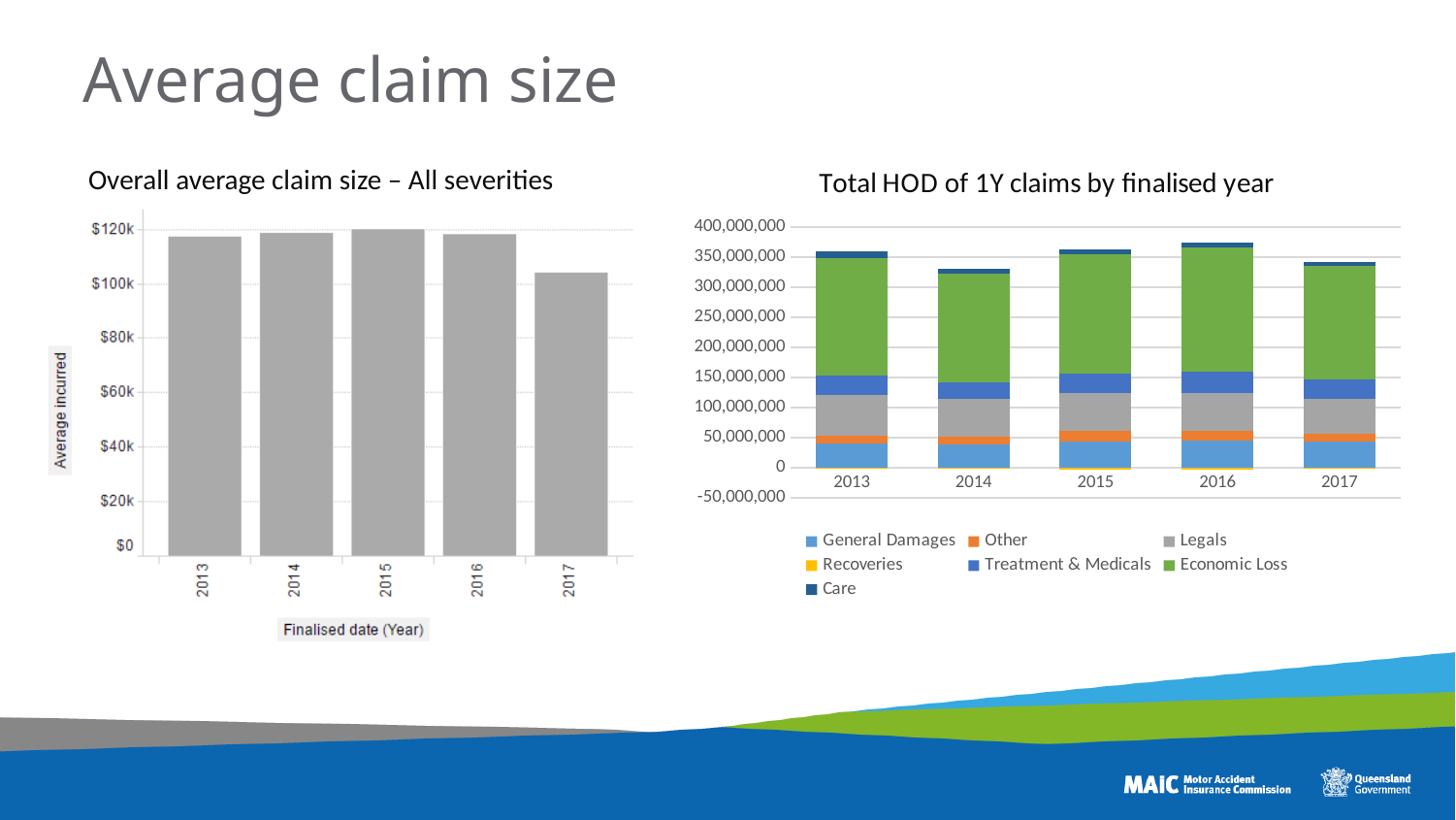
In the 'Total HOD of 1Y claims by finalised year' chart, is the total stacked bar for 2016 greater or less than 350,000,000? greater In the 'Total HOD of 1Y claims by finalised year' chart, what colour represents Economic Loss in the legend? green How many series does the legend of the 'Total HOD of 1Y claims by finalised year' chart list? 7 What kind of chart is the 'Overall average claim size – All severities' chart? bar chart In the 'Overall average claim size – All severities' chart, how many years are shown on the x axis? 5 What kind of chart is the 'Total HOD of 1Y claims by finalised year' chart? stacked bar chart In the 'Overall average claim size – All severities' chart, is the value for 2017 greater or less than $100k? greater In the 'Overall average claim size – All severities' chart, is the value for 2017 greater or less than $120k? less In the 'Overall average claim size – All severities' chart, which is larger, the value for 2013 or the value for 2017? 2013 In the 'Overall average claim size – All severities' chart, which year has the lowest average claim size? 2017 In the 'Overall average claim size – All severities' chart, does the average claim size rise or fall from 2016 to 2017? fall